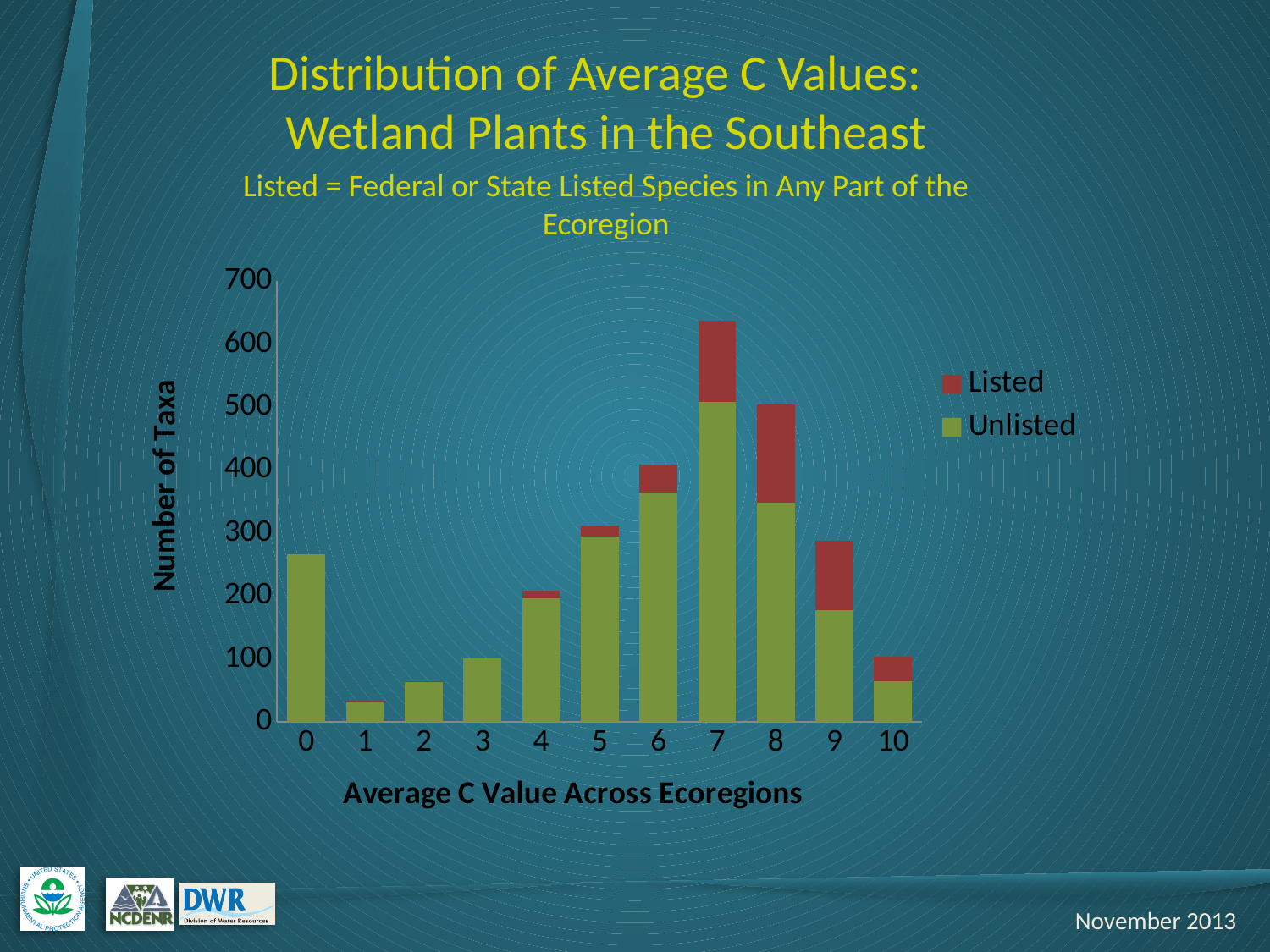
Which has a larger total bar, average C value 6 or average C value 9? 6 What is the title of the y axis? Number of Taxa Which average C value has the shortest total bar? 1 How many series does the legend list? 2 Is the total number of taxa for average C value 7 greater or less than 600? greater Which has a larger total bar, average C value 0 or average C value 3? 0 Which average C value has the tallest total bar? 7 What kind of chart is shown on the slide? bar chart How many average C value categories are shown on the x axis? 11 Is the total number of taxa for average C value 0 greater or less than 200? greater Is the total number of taxa for average C value 2 greater or less than 100? less